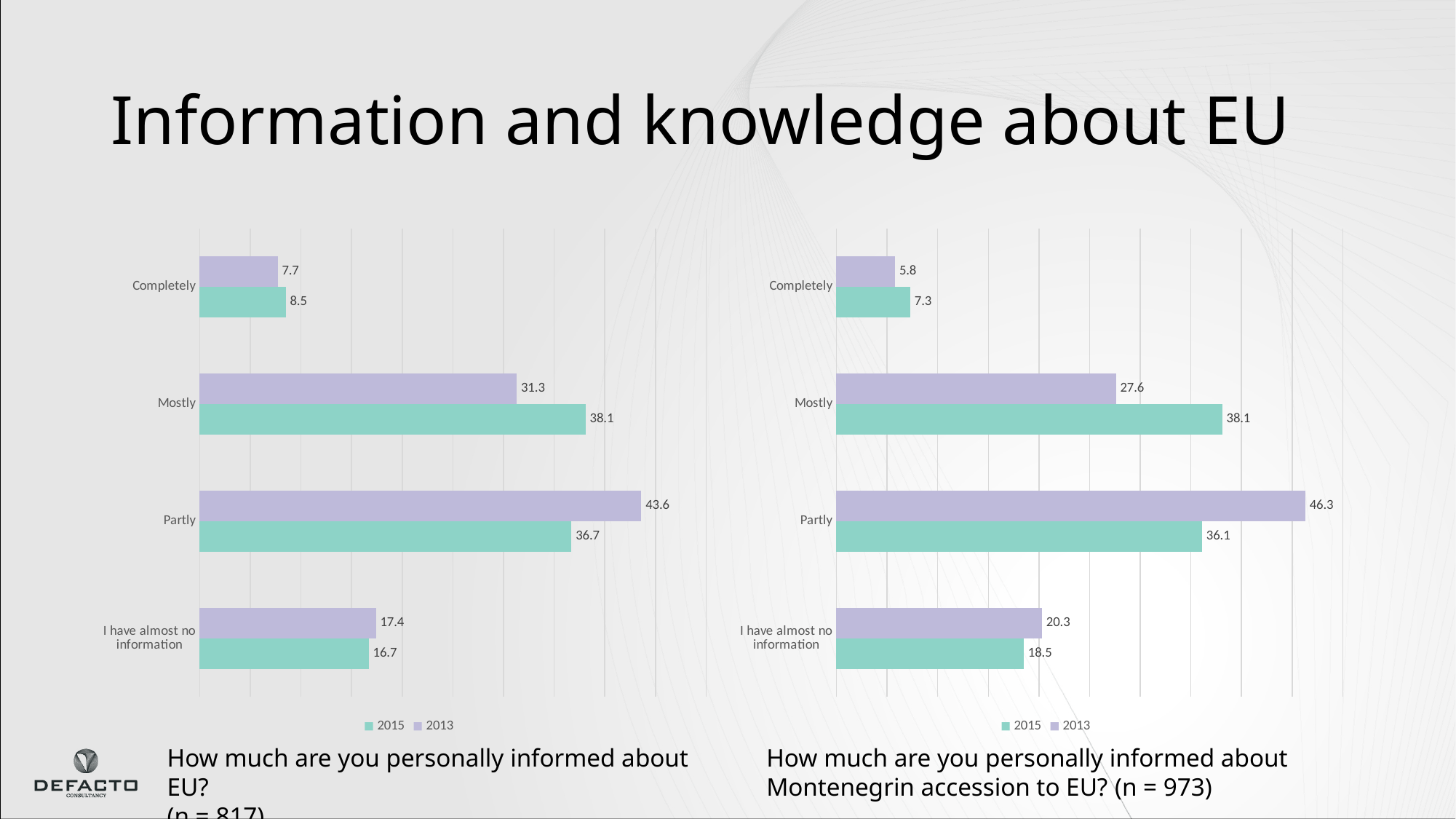
In the left chart (informed about EU), what is the 2015 value for Mostly? 38.1 In the left chart (informed about EU), what is the 2013 value for Partly? 43.6 How many categories are shown in the right chart (informed about Montenegrin accession to EU)? 4 In the right chart (informed about Montenegrin accession to EU), what is the difference between the 2015 and 2013 values for Mostly? 10.5 In the right chart (informed about Montenegrin accession to EU), what is the 2015 value for Completely? 7.3 In the right chart (informed about Montenegrin accession to EU), which category has the lowest 2015 value? Completely In the right chart (informed about Montenegrin accession to EU), what is the 2013 value for I have almost no information? 20.3 In the left chart (informed about EU), which is larger for Mostly: the 2015 value or the 2013 value? 2015 What type of chart is used on this slide? Bar chart In the left chart (informed about EU), which category has the highest 2013 value? Partly In the left chart (informed about EU), what is the difference between the 2013 and 2015 values for Partly? 6.9 How many series does the legend of the left chart (informed about EU) list? 2